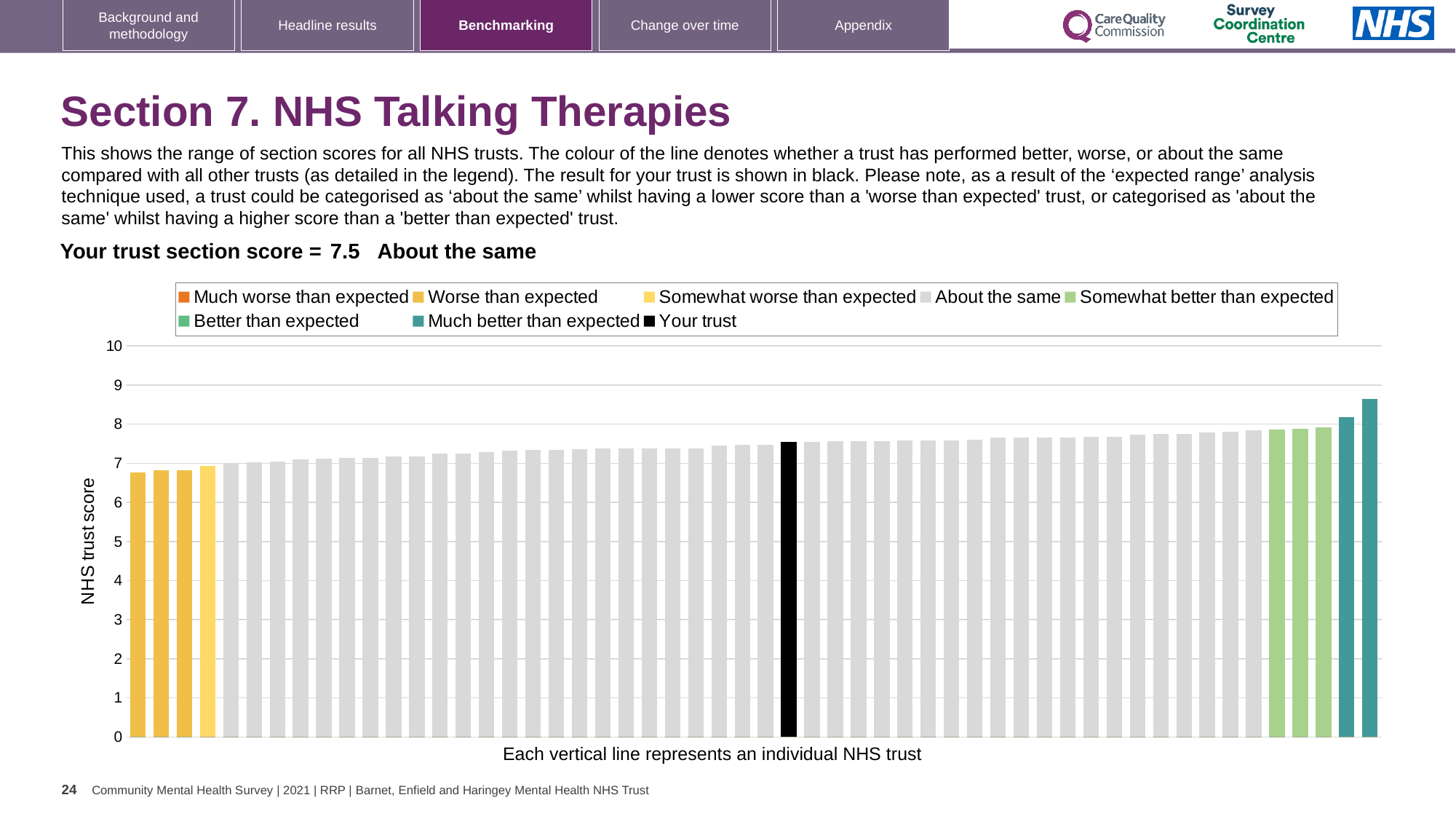
What is the section score for your trust? 7.5 Is the value for your trust greater or less than 7? greater How many entries does the chart legend list? 8 Which legend category does the tallest bar belong to? Much better than expected Is the lowest trust score on the chart greater or less than 7? less How many bars are coloured as 'Much better than expected'? 2 What kind of chart is shown on the slide? bar chart Is the highest trust score on the chart greater or less than 8? greater Do the bar values rise or fall from left to right along the x axis? rise Which legend category does the shortest bar belong to? Worse than expected Which benchmarking category is your trust placed in for this section? About the same What is the label on the vertical axis of the chart? NHS trust score